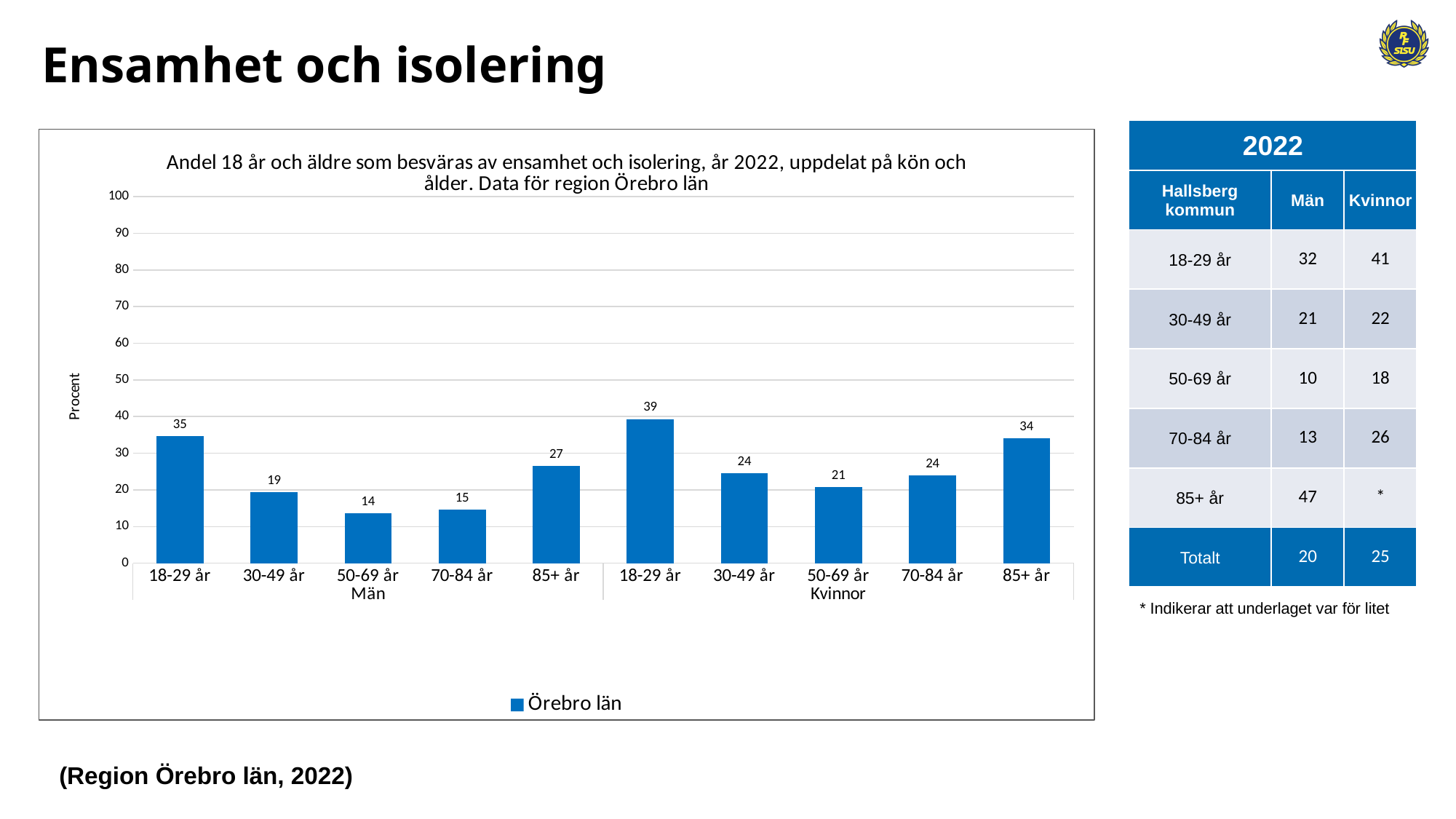
What is the value for women aged 85+ år in the chart? 34 What is the value for women aged 50-69 år in the chart? 21 What is the value for men aged 18-29 år in the chart? 35 What kind of chart is shown on the slide? Bar chart How many bars are plotted in the chart? 10 Which group has the highest value in the chart? Kvinnor 18-29 år Is the value for men aged 85+ år greater or less than 20? greater Which is larger: the value for men aged 85+ år or women aged 85+ år? Kvinnor 85+ år How many series does the chart legend list? 1 Which group has the lowest value in the chart? Män 50-69 år What is the label of the y axis in the chart? Procent What is the difference between the values for women aged 18-29 år and men aged 18-29 år? 4